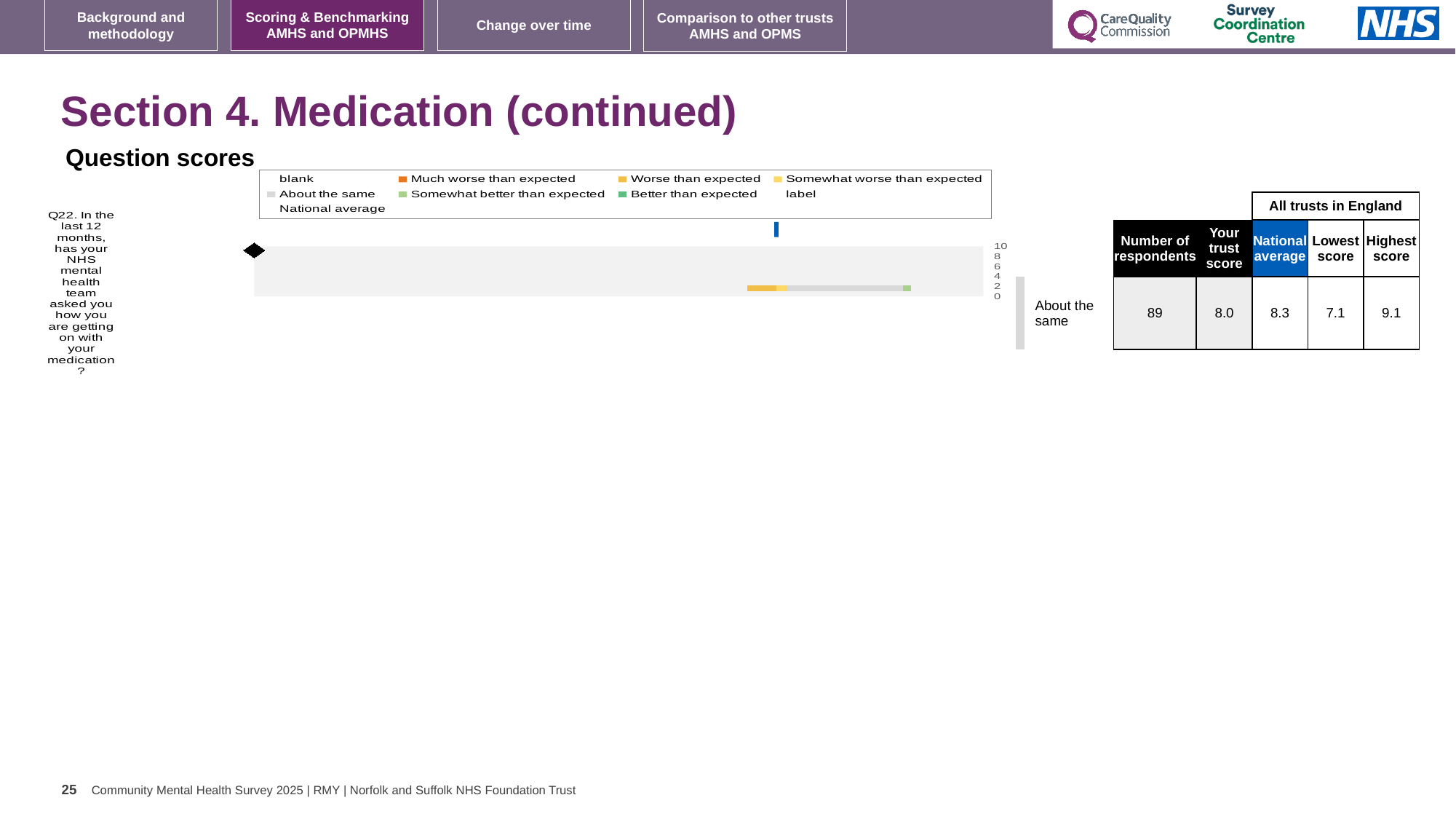
In the table beside the chart, what is the trust's score for Q22? 8.0 For Q22, what is the difference between the national average and the trust's score? 0.3 In the table beside the chart, what is the highest score among all trusts in England for Q22? 9.1 How many questions (categories) are plotted in the Question scores chart? 1 Which question is plotted in the Question scores chart? Q22. In the last 12 months, has your NHS mental health team asked you how you are getting on with your medication? In the table beside the chart, what is the lowest score among all trusts in England for Q22? 7.1 In the table beside the chart, what is the national average for Q22? 8.3 For Q22, what is the difference between the highest and lowest scores among all trusts in England? 2.0 For Q22, which is larger: the trust's score or the national average? national average What benchmark category is shown next to the bar for Q22? About the same How many respondents answered Q22 according to the table beside the chart? 89 What kind of chart is shown under 'Question scores'? bar chart